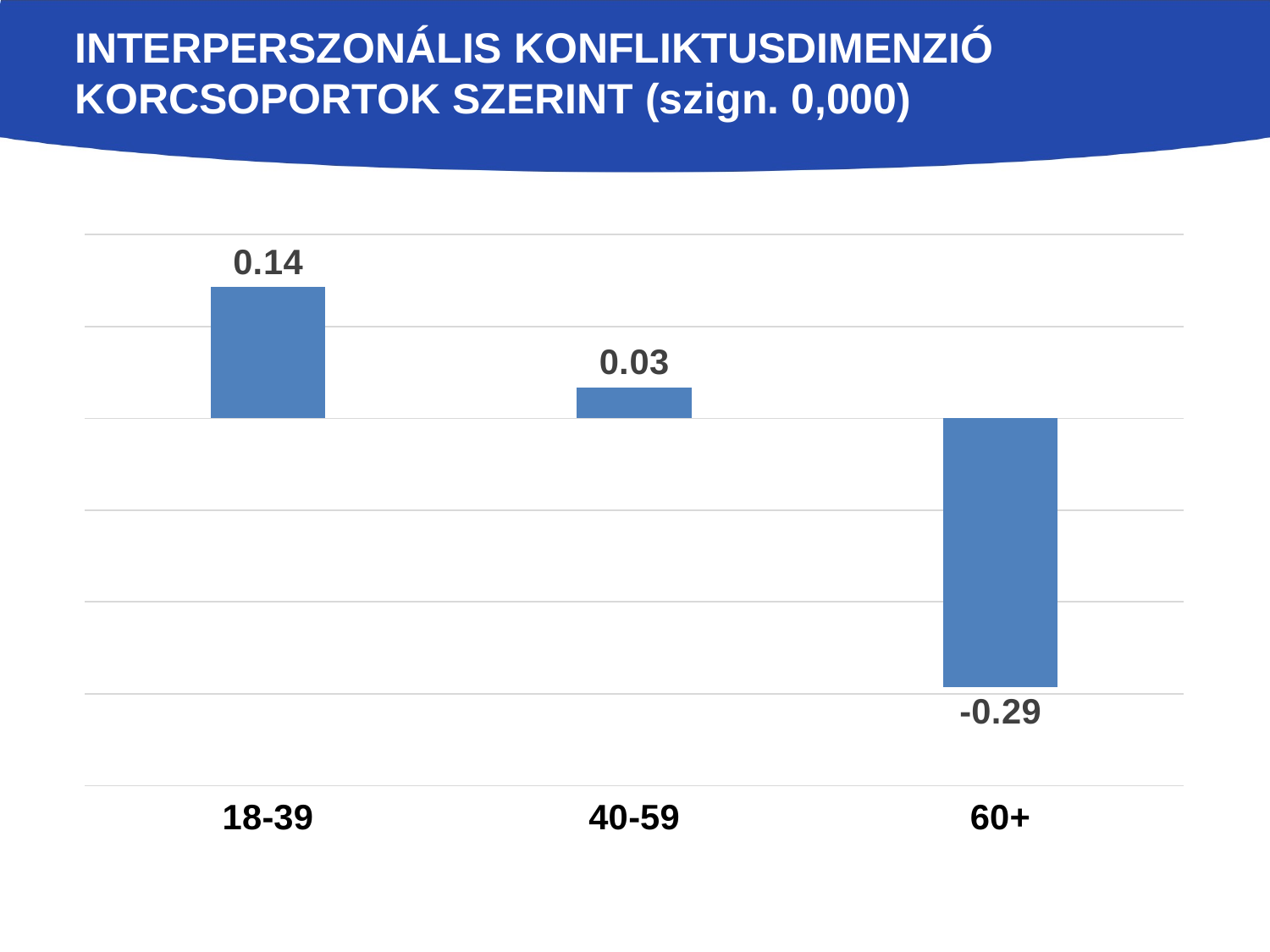
Which age group has the highest value? 18-39 Which age group has the lowest value? 60+ What kind of chart is shown on the slide? bar chart What significance value is given in the chart title? 0,000 What is the difference between the values for 18-39 and 40-59? 0.11 What is the difference between the values for 18-39 and 60+? 0.43 Do the values rise or fall from the 18-39 group to the 60+ group? fall What is the value for the 60+ age group? -0.29 What is the value for the 18-39 age group? 0.14 What is the value for the 40-59 age group? 0.03 Which is larger, the value for 40-59 or the value for 60+? 40-59 How many age groups are shown in the chart? 3